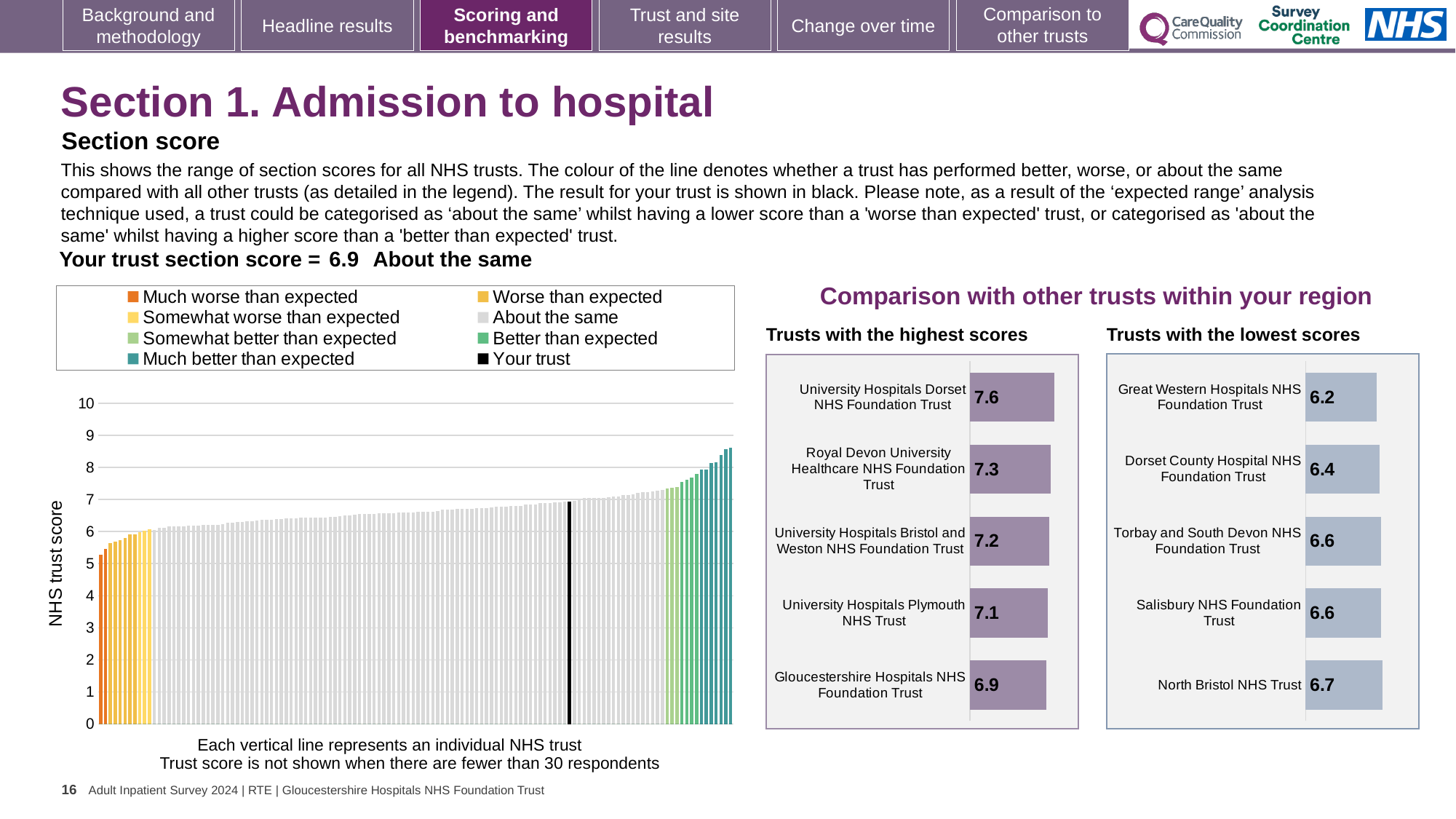
In the 'Trusts with the lowest scores' chart, which has the larger score: Dorset County Hospital NHS Foundation Trust or North Bristol NHS Trust? North Bristol NHS Trust In the main 'NHS trust score' chart on the left, do the bar values rise or fall from left to right? rise How many trusts are shown in the 'Trusts with the lowest scores' chart? 5 In the 'Trusts with the highest scores' chart, what is the difference between the scores of University Hospitals Dorset NHS Foundation Trust and Gloucestershire Hospitals NHS Foundation Trust? 0.7 In the 'Trusts with the highest scores' chart, what is the score for University Hospitals Plymouth NHS Trust? 7.1 In the 'Trusts with the lowest scores' chart, what is the score for Great Western Hospitals NHS Foundation Trust? 6.2 How many entries does the legend of the main 'NHS trust score' chart list? 8 In the 'Trusts with the highest scores' chart, which trust has the lowest score? Gloucestershire Hospitals NHS Foundation Trust In the 'Trusts with the highest scores' chart, what is the score for University Hospitals Dorset NHS Foundation Trust? 7.6 In the main 'NHS trust score' chart on the left, is the value of the leftmost (orange) bar greater or less than 6? less In the 'Trusts with the lowest scores' chart, which trust has the highest score? North Bristol NHS Trust In the main 'NHS trust score' chart on the left, what is the section score for your trust (the black bar)? 6.9